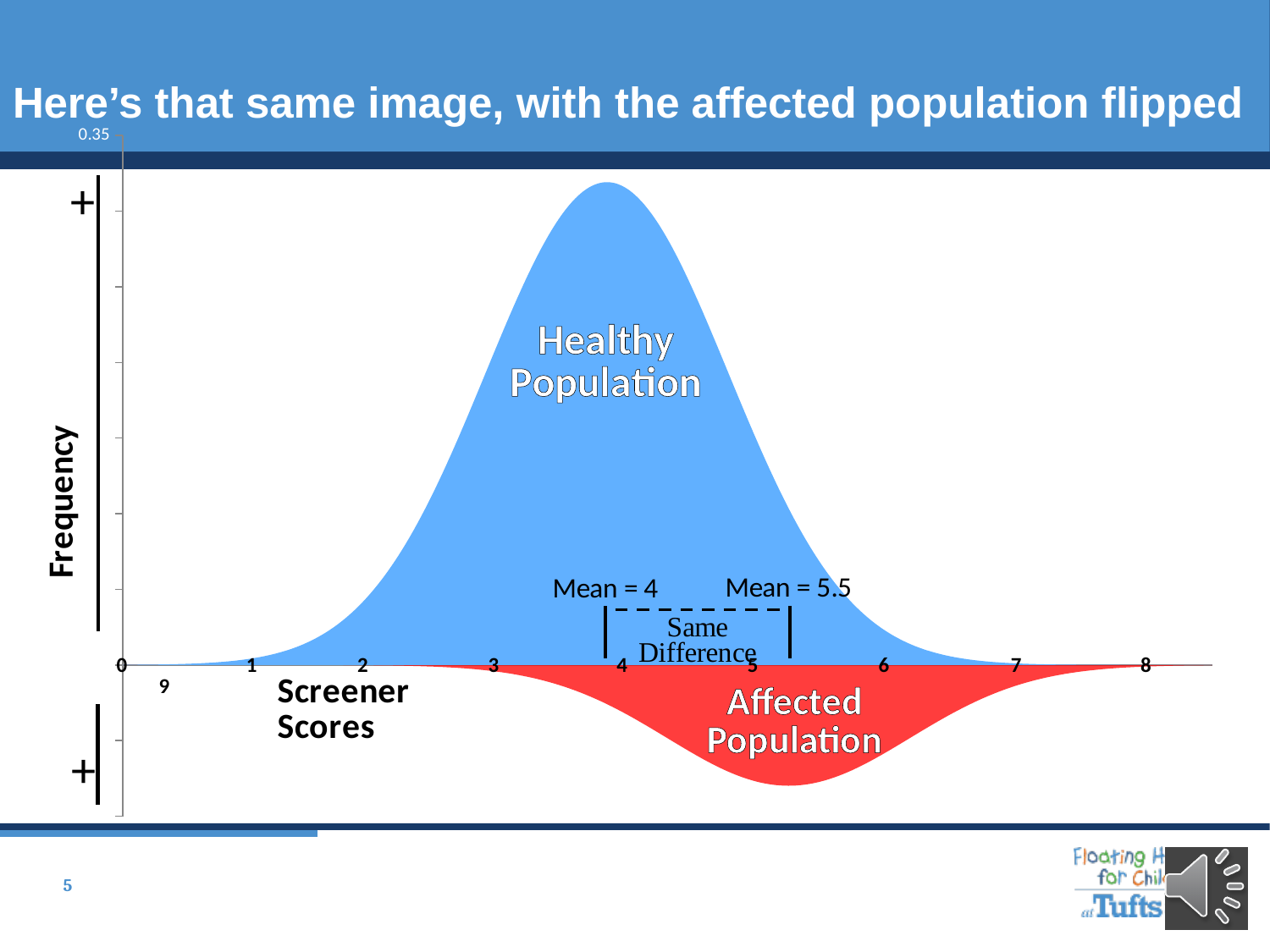
Which population has the higher mean, the Healthy Population or the Affected Population? Affected Population What is the label of the x axis? Screener Scores Which population is drawn below the horizontal axis (flipped)? Affected Population Is the mean of the Healthy Population greater or less than 5? less What kind of chart is shown on the slide? Area chart What is the mean of the Affected Population shown on the chart? 5.5 Is the mean of the Affected Population greater or less than 5? greater What is the mean of the Healthy Population shown on the chart? 4 What is the difference between the mean of the Affected Population and the mean of the Healthy Population? 1.5 What is the label of the y axis? Frequency How many populations (series) are plotted on the chart? 2 At which screener score does the Healthy Population curve reach its peak? 4